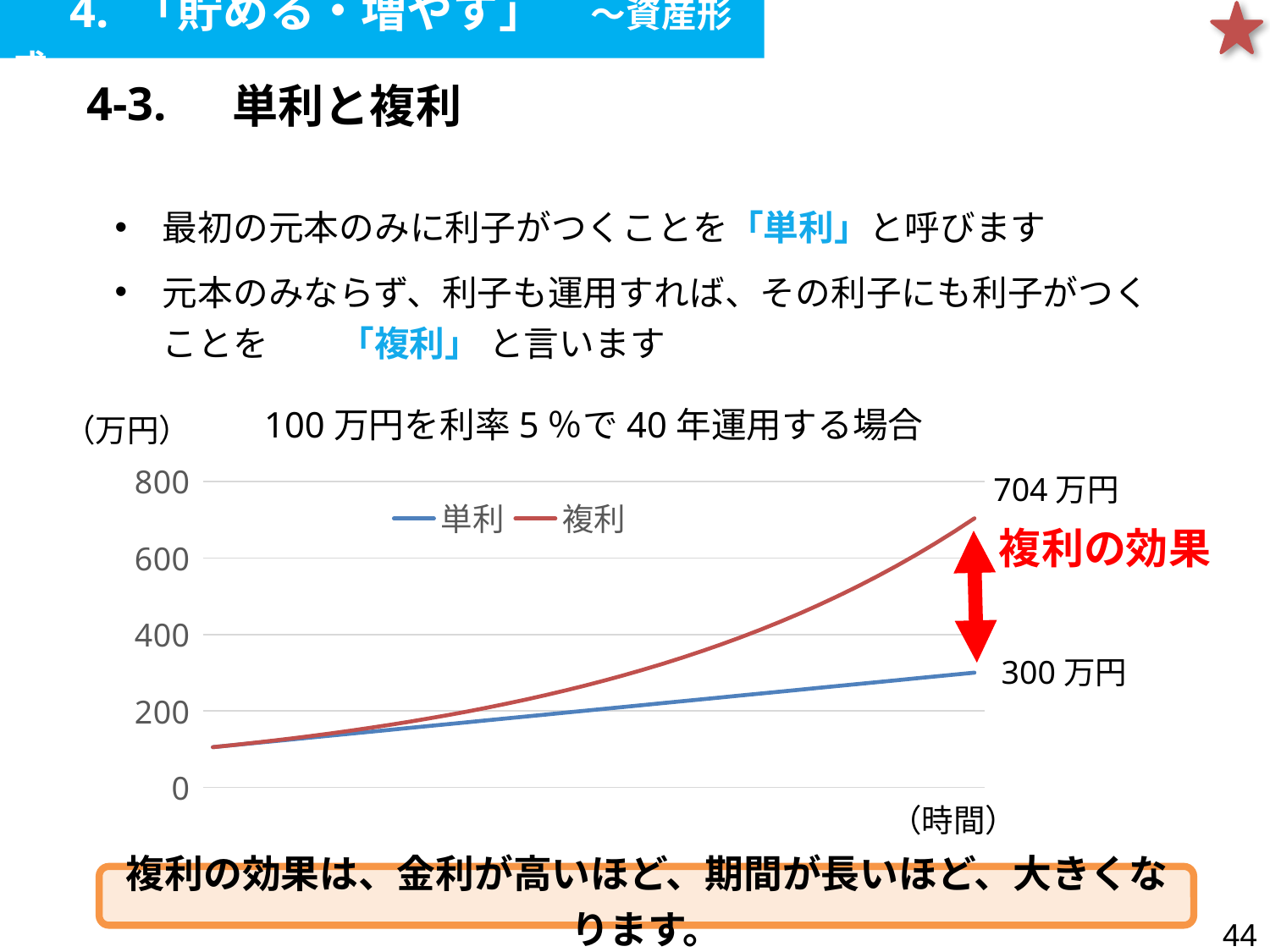
What kind of chart is shown on the slide? line chart How many series does the chart's legend list? 2 What is the final value labeled for the 単利 (simple interest) line? 300万円 Is the final value of the 複利 line greater or less than 600? greater What is the highest value shown on the chart's y axis? 800 Is the final value of the 単利 line greater or less than 400? less What are the two series named in the chart's legend? 単利 and 複利 What is the title of the chart? 100万円を利率5％で40年運用する場合 What is the difference between the final values of the 複利 line and the 単利 line? 404万円 What is the final value labeled for the 複利 (compound interest) line? 704万円 Which line ends at a higher value, 単利 or 複利? 複利 Do the values of the 複利 line rise or fall along the x axis? rise